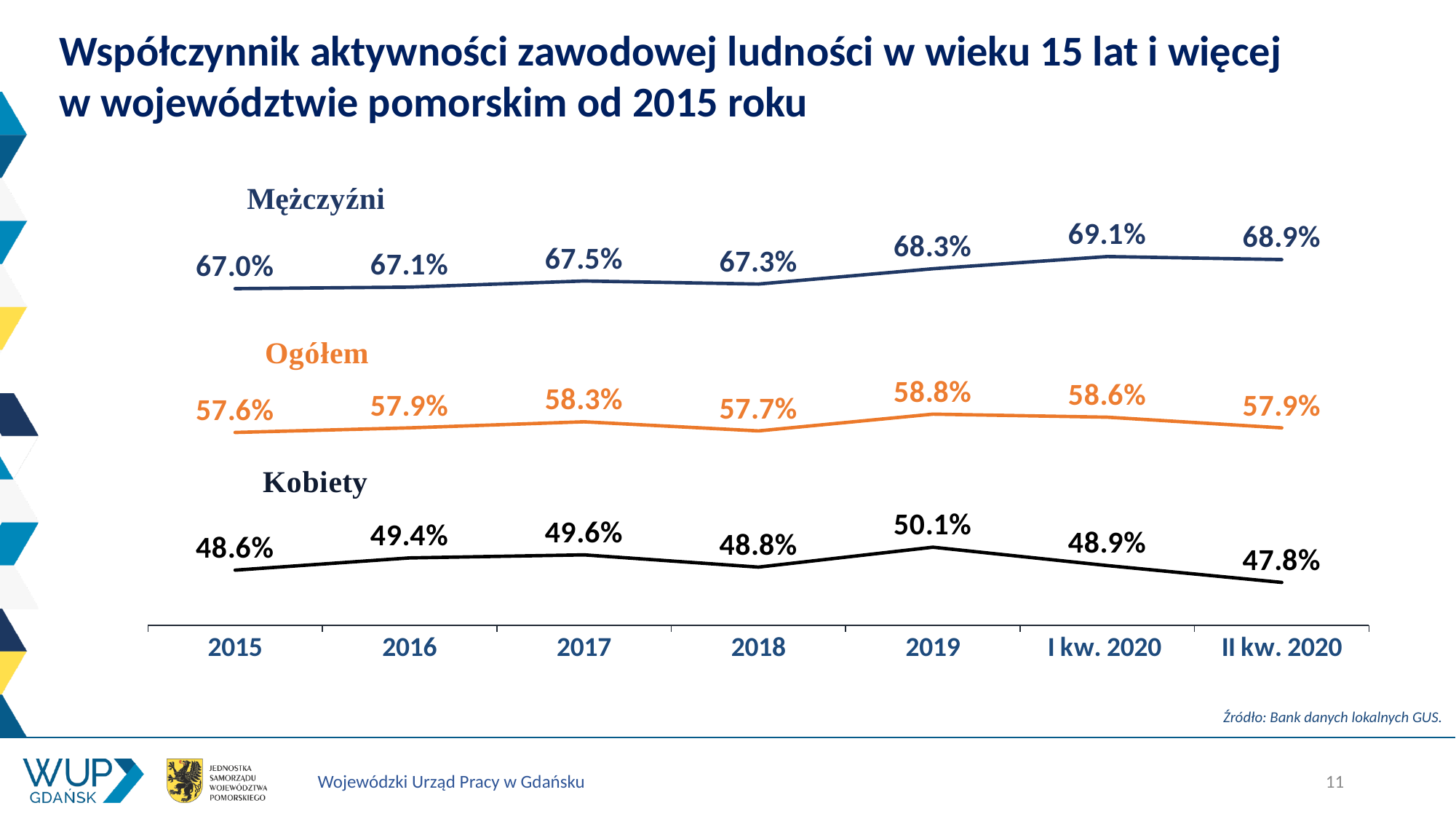
What is the value for Kobiety in II kw. 2020? 47.8% Does the Kobiety series rise or fall between 2019 and II kw. 2020? Fall Which series is drawn in orange? Ogółem In which period does the Mężczyźni series reach its highest value? I kw. 2020 How many series are plotted on the chart? 3 What is the value for Mężczyźni in 2017? 67.5% How many time periods are shown on the x axis? 7 Which is larger: the Ogółem value in 2017 or the Ogółem value in 2018? 2017 (58.3%) What is the difference between the Mężczyźni and Kobiety values in 2015? 18.4 percentage points What is the value for Ogółem in 2019? 58.8% In which period does the Kobiety series reach its lowest value? II kw. 2020 What type of chart is shown on the slide? Line chart